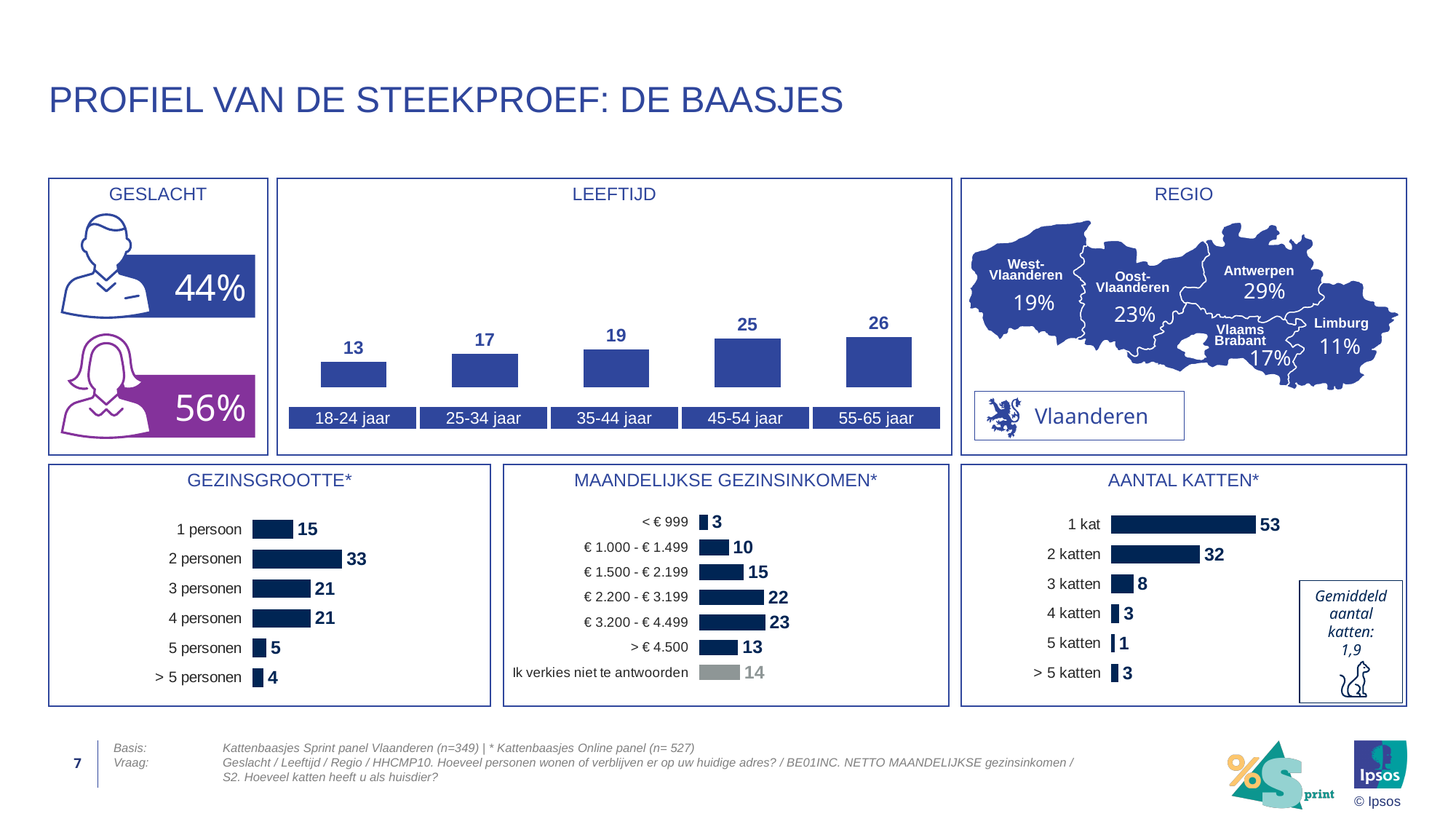
In the GEZINSGROOTTE* chart, what is the value for 2 personen? 33 In the LEEFTIJD chart, what is the value for 35-44 jaar? 19 In the AANTAL KATTEN* chart, what is the difference between 1 kat and 2 katten? 21 In the GEZINSGROOTTE* chart, what is the difference between 2 personen and 1 persoon? 18 In the GEZINSGROOTTE* chart, which category has the lowest value? > 5 personen In the LEEFTIJD chart, which age group has the highest value? 55-65 jaar In the AANTAL KATTEN* chart, what is the value for 1 kat? 53 In the MAANDELIJKSE GEZINSINKOMEN* chart, what is the value for € 3.200 - € 4.499? 23 What type of chart is the AANTAL KATTEN* chart? bar chart In the MAANDELIJKSE GEZINSINKOMEN* chart, which is larger: € 1.000 - € 1.499 or > € 4.500? > € 4.500 In the LEEFTIJD chart, do the values rise or fall from 18-24 jaar to 55-65 jaar? rise In the LEEFTIJD chart, how many age groups are shown? 5